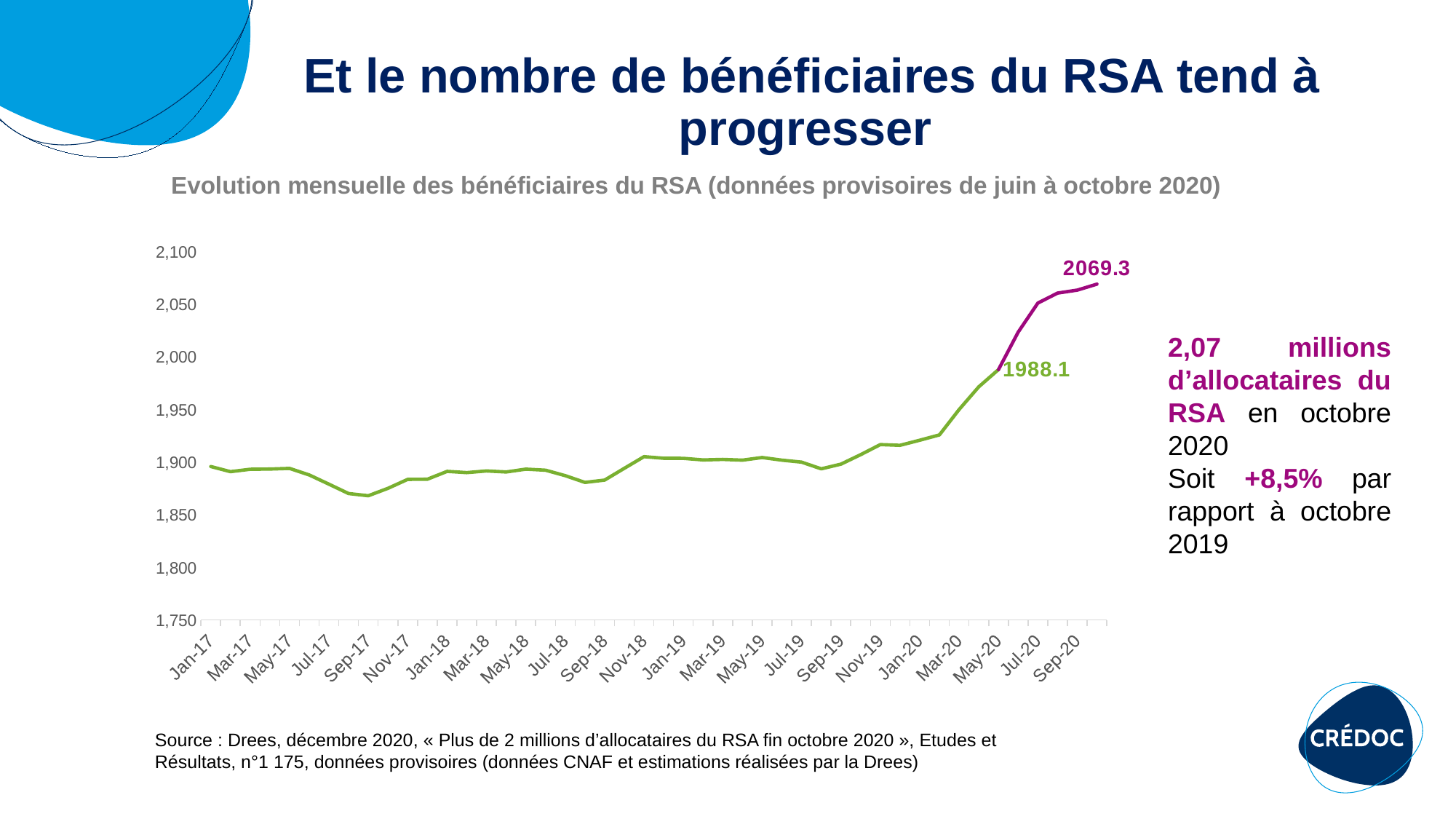
Is the value for Jul-20 greater or less than 2,000? greater What value is shown by the data label where the green part of the line meets the purple part? 1988.1 Does the line rise or fall between Mar-20 and the end of the series? rise What is the highest value shown on the vertical axis? 2,100 What is the title of the chart? Evolution mensuelle des bénéficiaires du RSA (données provisoires de juin à octobre 2020) Which is higher, the value for Nov-18 or the value for Sep-18? Nov-18 What value is shown by the data label at the end of the line (October 2020)? 2069.3 Is the value for Sep-17 greater or less than 1,900? less What kind of chart is shown on the slide? line chart At which point does the line reach its highest value? the last point (October 2020) What is the difference between the two labelled values, 2069.3 and 1988.1? 81.2